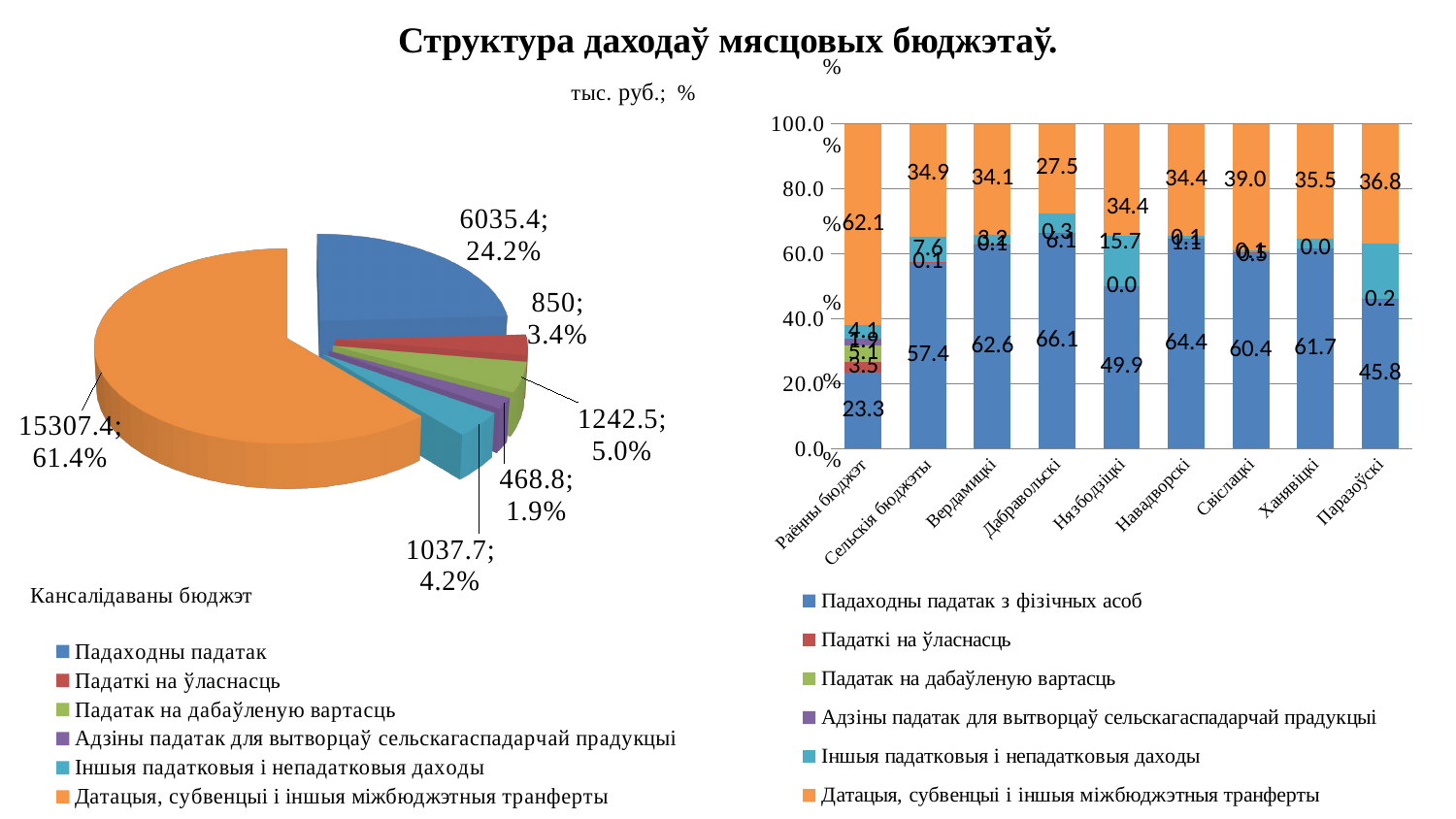
What kind of chart is the left chart (Кансалідаваны бюджэт)? pie chart How many slices does the left pie chart have? 6 What kind of chart is the right chart? stacked bar chart In the left pie chart, which category has the largest slice? Датацыя, субвенцыі і іншыя міжбюджэтныя трансферты How many categories are shown on the x axis of the right bar chart? 9 In the left pie chart, what value and share are shown for Падаходны падатак? 6035.4; 24.2% In the right bar chart, what is the difference between the Датацыя, субвенцыі і іншыя міжбюджэтныя трансферты values for Свіслацкі and Дабравольскі? 11.5 In the right bar chart, which category has the highest value for Падаходны падатак з фізічных асоб? Дабравольскі In the left pie chart, which category has the smallest slice? Адзіны падатак для вытворцаў сельскагаспадарчай прадукцыі In the right bar chart, what is the value of Падаходны падатак з фізічных асоб for Дабравольскі? 66.1 How many series does the legend of the right bar chart list? 6 In the left pie chart, what share does Датацыя, субвенцыі і іншыя міжбюджэтныя трансферты have? 61.4%